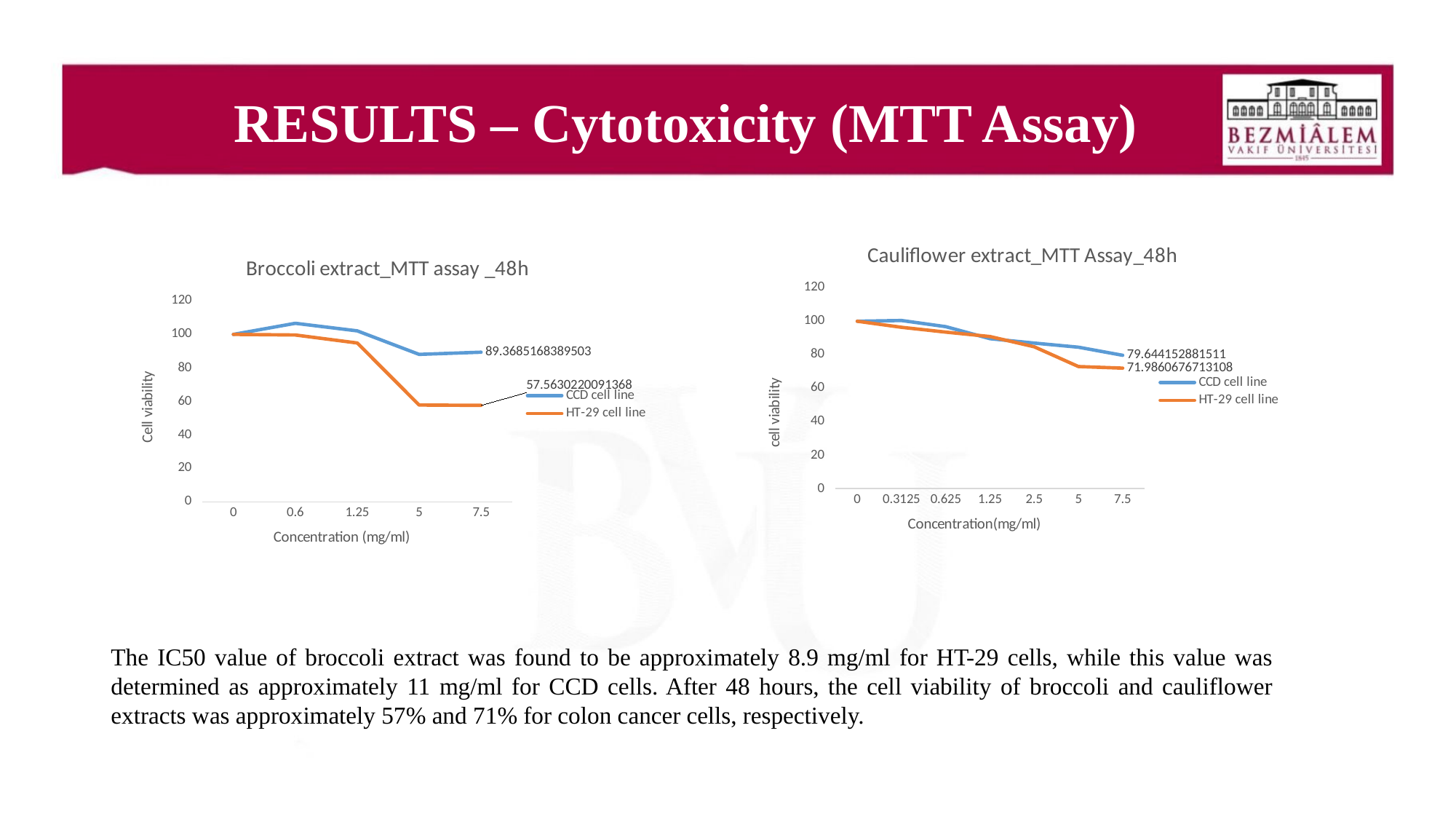
How many series does the legend of the Broccoli extract_MTT assay _48h chart list? 2 How many concentration points are plotted on the x axis of the Cauliflower extract_MTT Assay_48h chart? 7 In the Cauliflower extract_MTT Assay_48h chart, what is the labelled cell viability of the HT-29 cell line at 7.5 mg/ml? 71.9860676713108 How many concentration points are plotted on the x axis of the Broccoli extract_MTT assay _48h chart? 5 In the Cauliflower extract_MTT Assay_48h chart, what is the difference between the labelled CCD and HT-29 values at 7.5 mg/ml? 7.6580852102002 In the Broccoli extract_MTT assay _48h chart, is the CCD cell line value at 0.6 mg/ml greater or less than 100? greater What kind of chart is the Cauliflower extract_MTT Assay_48h chart? Line chart In the Cauliflower extract_MTT Assay_48h chart, what is the labelled cell viability of the CCD cell line at 7.5 mg/ml? 79.644152881511 In the Broccoli extract_MTT assay _48h chart, what is the labelled cell viability of the HT-29 cell line at 7.5 mg/ml? 57.5630220091368 In the Broccoli extract_MTT assay _48h chart, which cell line has the higher viability at 7.5 mg/ml? CCD cell line In the Broccoli extract_MTT assay _48h chart, what is the difference between the labelled CCD and HT-29 values at 7.5 mg/ml? 31.8054948298135 In the Broccoli extract_MTT assay _48h chart, what is the labelled cell viability of the CCD cell line at 7.5 mg/ml? 89.3685168389503